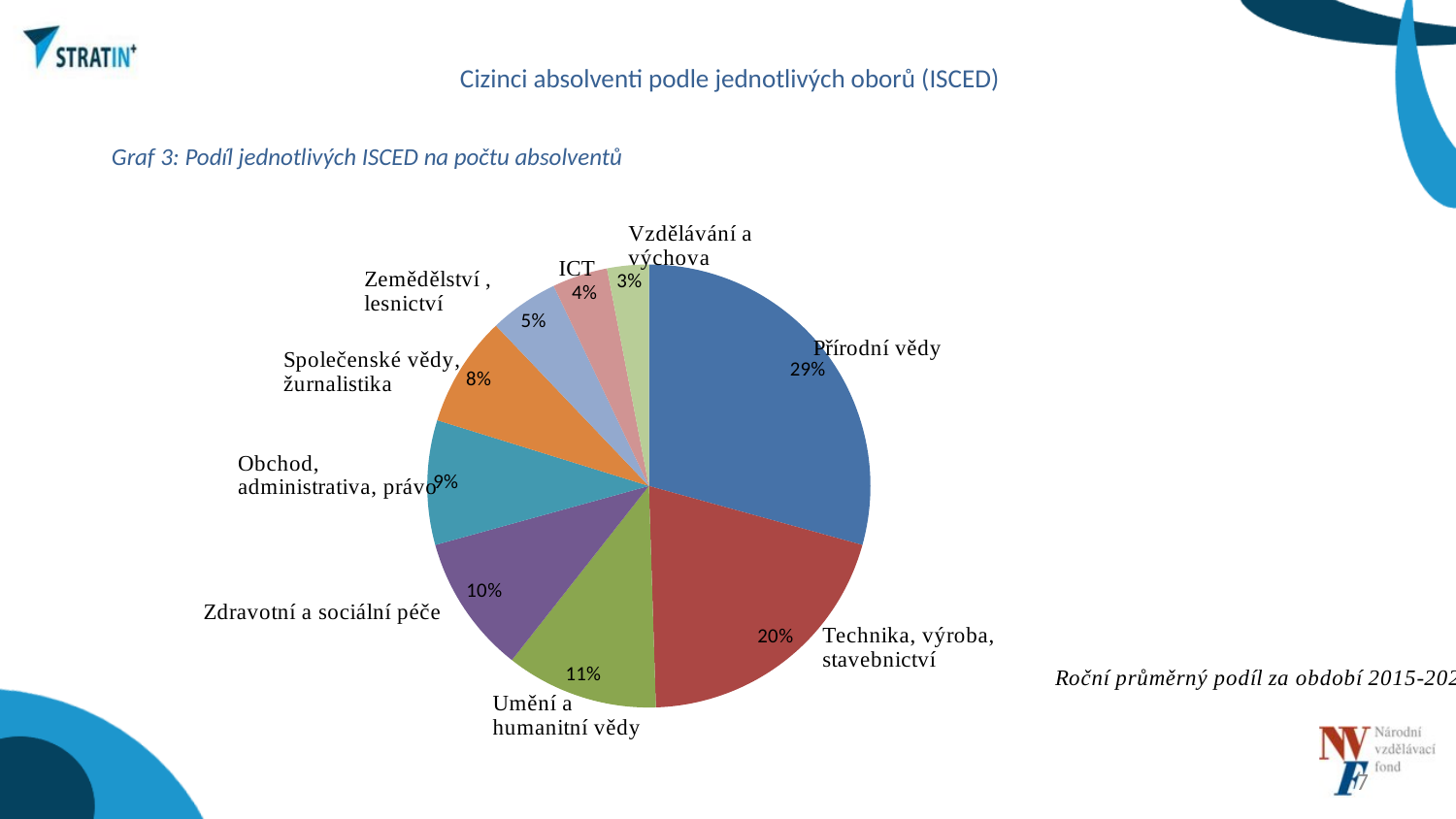
What kind of chart is shown on the slide? pie chart What share of the pie does Technika, výroba, stavebnictví have? 20% What is the value shown for Umění a humanitní vědy? 11% What share of the pie does Přírodní vědy have? 29% Which category has the smallest slice of the pie? Vzdělávání a výchova Which is larger, the share for Obchod, administrativa, právo or the share for Společenské vědy, žurnalistika? Obchod, administrativa, právo Which category has the largest slice of the pie? Přírodní vědy What is the value shown for Zdravotní a sociální péče? 10% What is the difference in percentage points between Přírodní vědy and Technika, výroba, stavebnictví? 9 What is the title of the chart (Graf 3)? Podíl jednotlivých ISCED na počtu absolventů What is the value shown for ICT? 4% How many slices does the pie chart have? 9